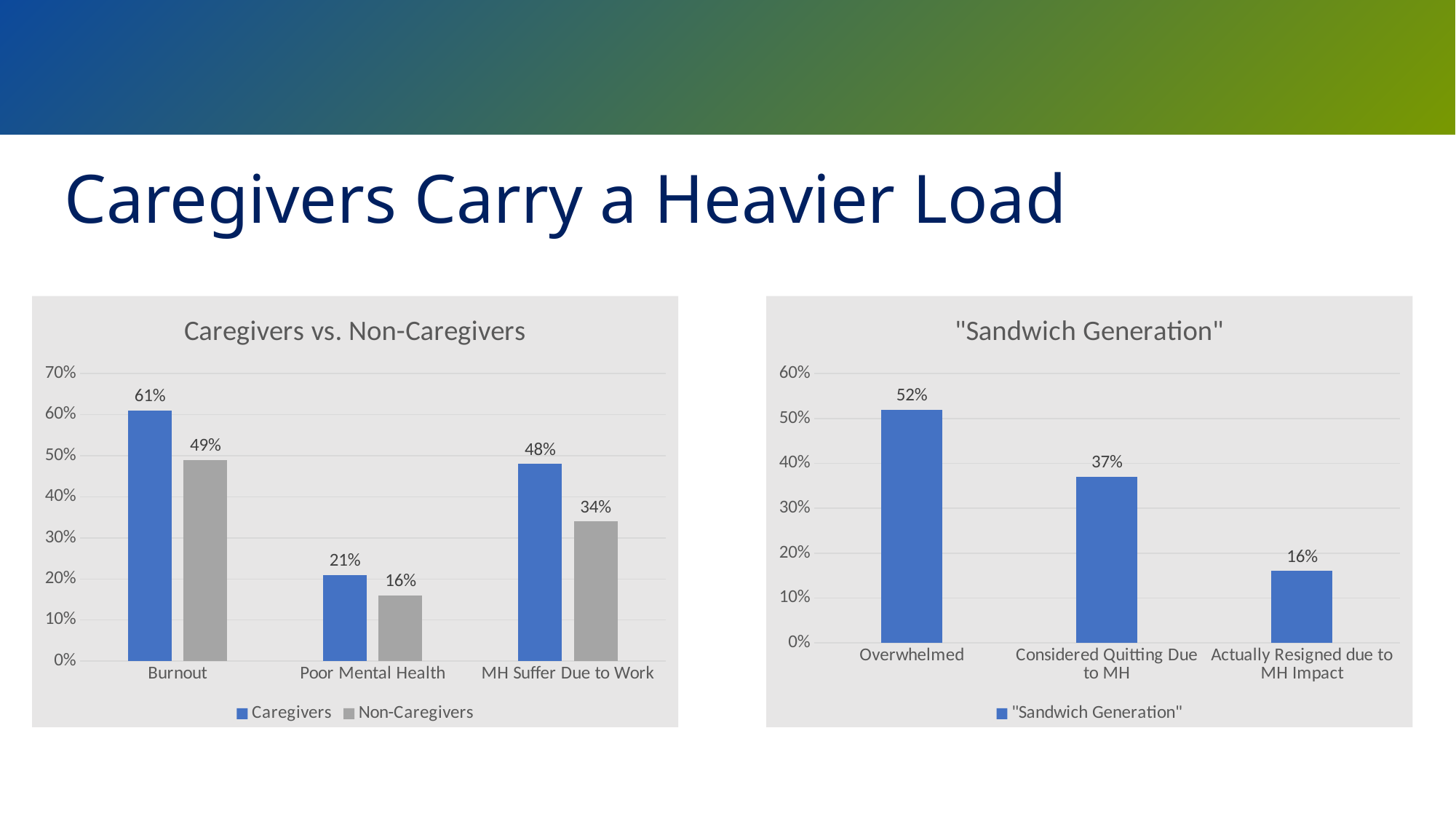
In the "Caregivers vs. Non-Caregivers" chart, which category has the lowest Caregivers value? Poor Mental Health In the "Caregivers vs. Non-Caregivers" chart, what is the value for Caregivers in the Burnout category? 61% In the "Sandwich Generation" chart, which category has the highest value? Overwhelmed In the "Sandwich Generation" chart, what is the difference between Overwhelmed and Actually Resigned due to MH Impact? 36% In the "Sandwich Generation" chart, what is the value for Considered Quitting Due to MH? 37% How many categories are shown on the x axis of the "Caregivers vs. Non-Caregivers" chart? 3 How many series does the legend of the "Caregivers vs. Non-Caregivers" chart list? 2 In the "Caregivers vs. Non-Caregivers" chart, which is larger for Burnout: Caregivers or Non-Caregivers? Caregivers In the "Sandwich Generation" chart, do the values rise or fall from left to right along the x axis? Fall What kind of chart is the "Sandwich Generation" chart? Bar chart In the "Caregivers vs. Non-Caregivers" chart, what is the value for Non-Caregivers in the Poor Mental Health category? 16% In the "Caregivers vs. Non-Caregivers" chart, what is the difference between Caregivers and Non-Caregivers for MH Suffer Due to Work? 14%